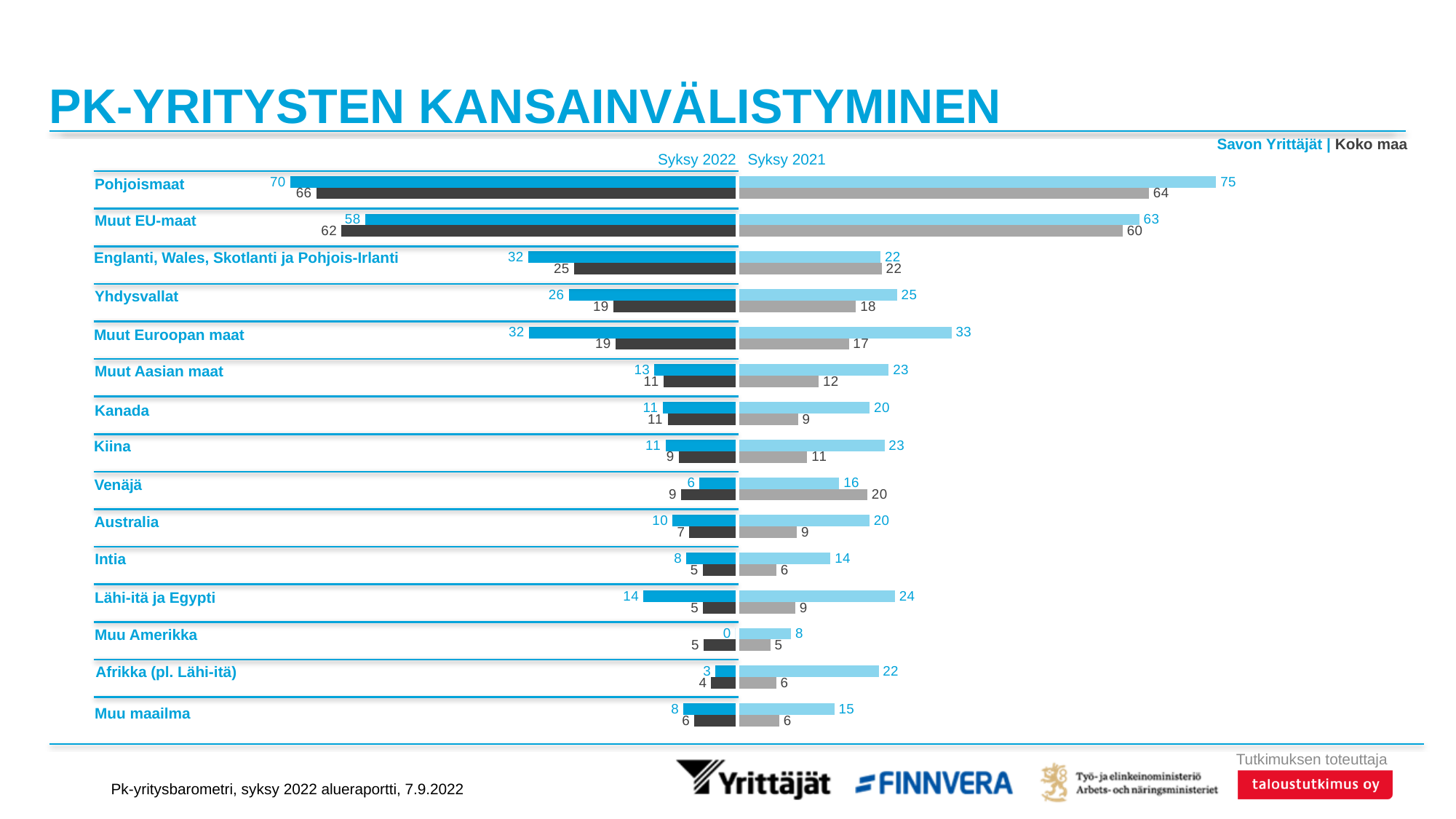
How many series does the legend list? 2 Which category has the lowest Savon Yrittäjät value in Syksy 2022? Muu Amerikka What is the difference between the Savon Yrittäjät and Koko maa values for Muut Euroopan maat in Syksy 2022? 13 In Syksy 2021, which is larger for Venäjä: the Savon Yrittäjät value or the Koko maa value? Koko maa What are the two time periods compared in the chart? Syksy 2022 and Syksy 2021 What is the Savon Yrittäjät value for Pohjoismaat in Syksy 2022? 70 What is the Koko maa value for Muut EU-maat in Syksy 2021? 60 How many categories (regions) are shown in the chart? 15 What is the Savon Yrittäjät value for Lähi-itä ja Egypti in Syksy 2021? 24 What is the difference between the Savon Yrittäjät values for Afrikka (pl. Lähi-itä) in Syksy 2021 and Syksy 2022? 19 What kind of chart is shown on the slide? Bar chart Which category has the highest Savon Yrittäjät value in Syksy 2022? Pohjoismaat